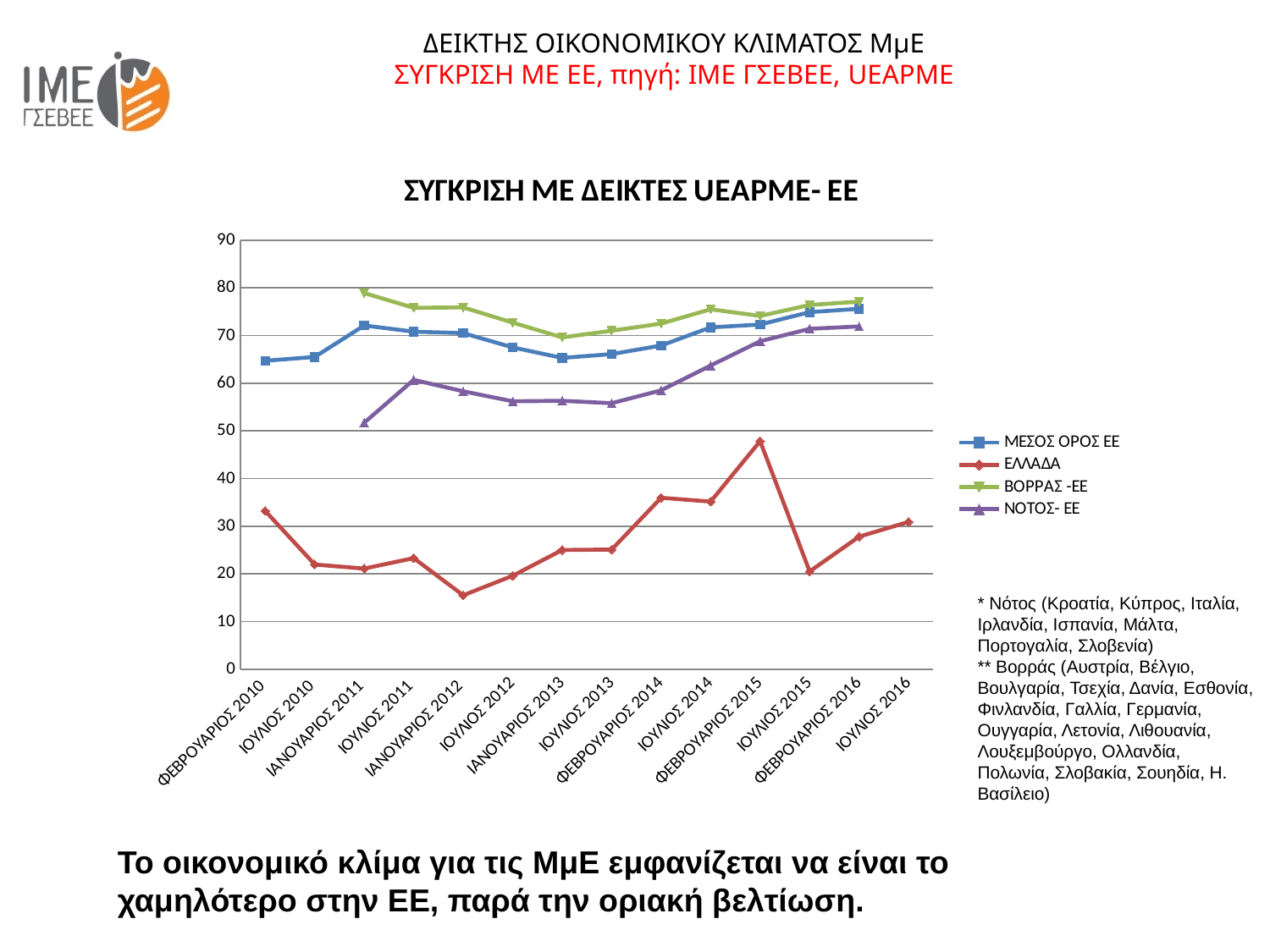
How many series does the legend list? 4 Is the value for ΒΟΡΡΑΣ -ΕΕ at ΙΑΝΟΥΑΡΙΟΣ 2011 greater or less than 70? greater Is the value for ΕΛΛΑΔΑ at ΦΕΒΡΟΥΑΡΙΟΣ 2015 greater or less than 40? greater At which time point does the ΕΛΛΑΔΑ series reach its lowest value? ΙΑΝΟΥΑΡΙΟΣ 2012 Is the value for ΝΟΤΟΣ- ΕΕ at ΙΑΝΟΥΑΡΙΟΣ 2011 greater or less than 60? less How many time points are shown on the x axis? 14 What kind of chart is shown on the slide? Line chart Which series has the lowest values throughout the chart? ΕΛΛΑΔΑ At which time point does the ΕΛΛΑΔΑ series reach its highest value? ΦΕΒΡΟΥΑΡΙΟΣ 2015